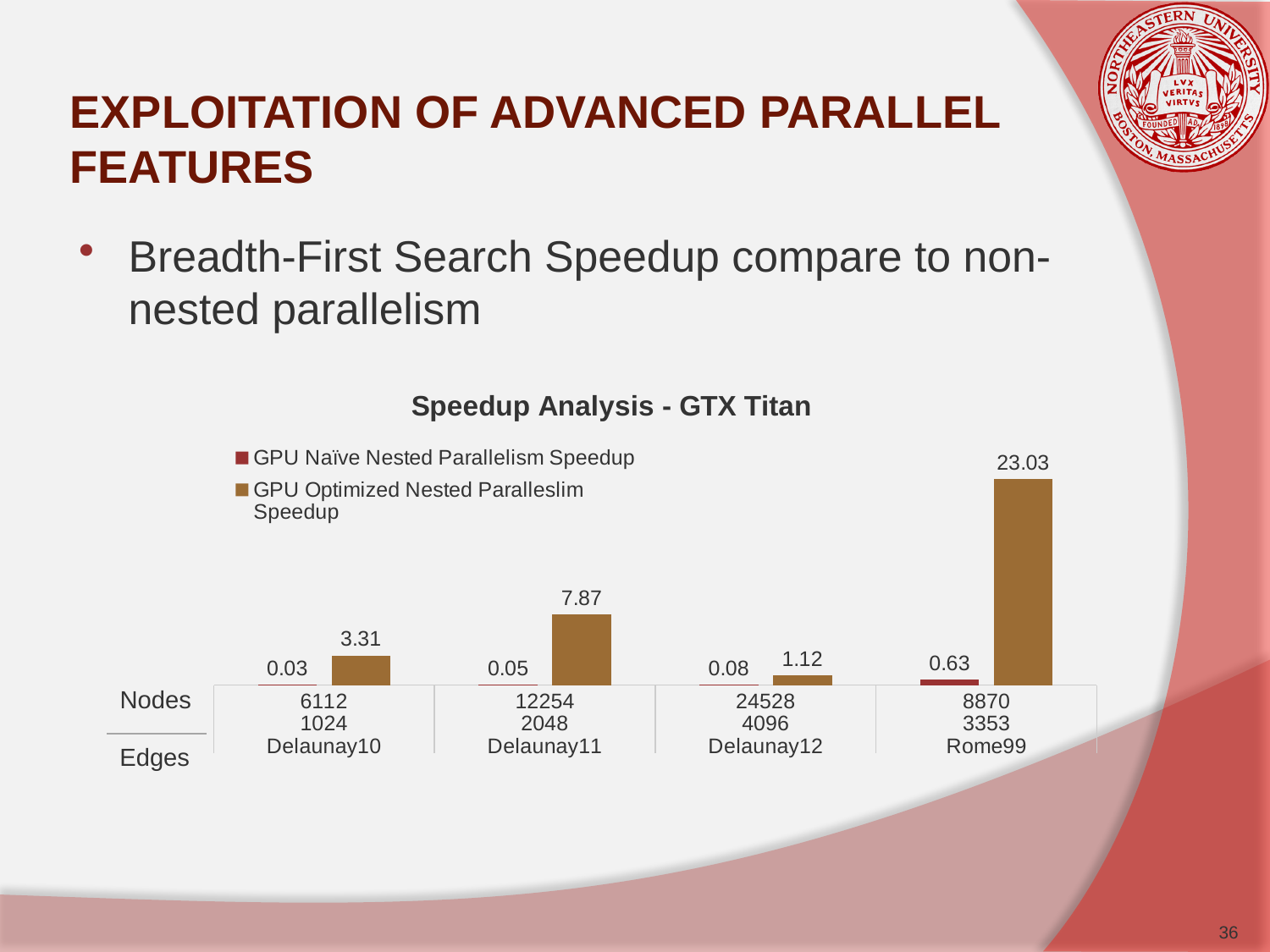
What is the GPU Optimized Nested Parallelism Speedup for Rome99? 23.03 Which graph has the highest GPU Optimized Nested Parallelism Speedup? Rome99 What kind of chart is shown on the slide? Bar chart What is the GPU Optimized Nested Parallelism Speedup for Delaunay12? 1.12 Which graph has the lowest GPU Naïve Nested Parallelism Speedup? Delaunay10 Which is larger: the GPU Optimized Nested Parallelism Speedup for Delaunay11 or for Delaunay12? Delaunay11 How many graphs (categories) are shown on the x axis? 4 How many series does the legend list? 2 What is the GPU Naïve Nested Parallelism Speedup for Delaunay11? 0.05 What is the title of the chart? Speedup Analysis - GTX Titan What is the difference between the GPU Optimized and GPU Naïve Nested Parallelism Speedup for Delaunay10? 3.28